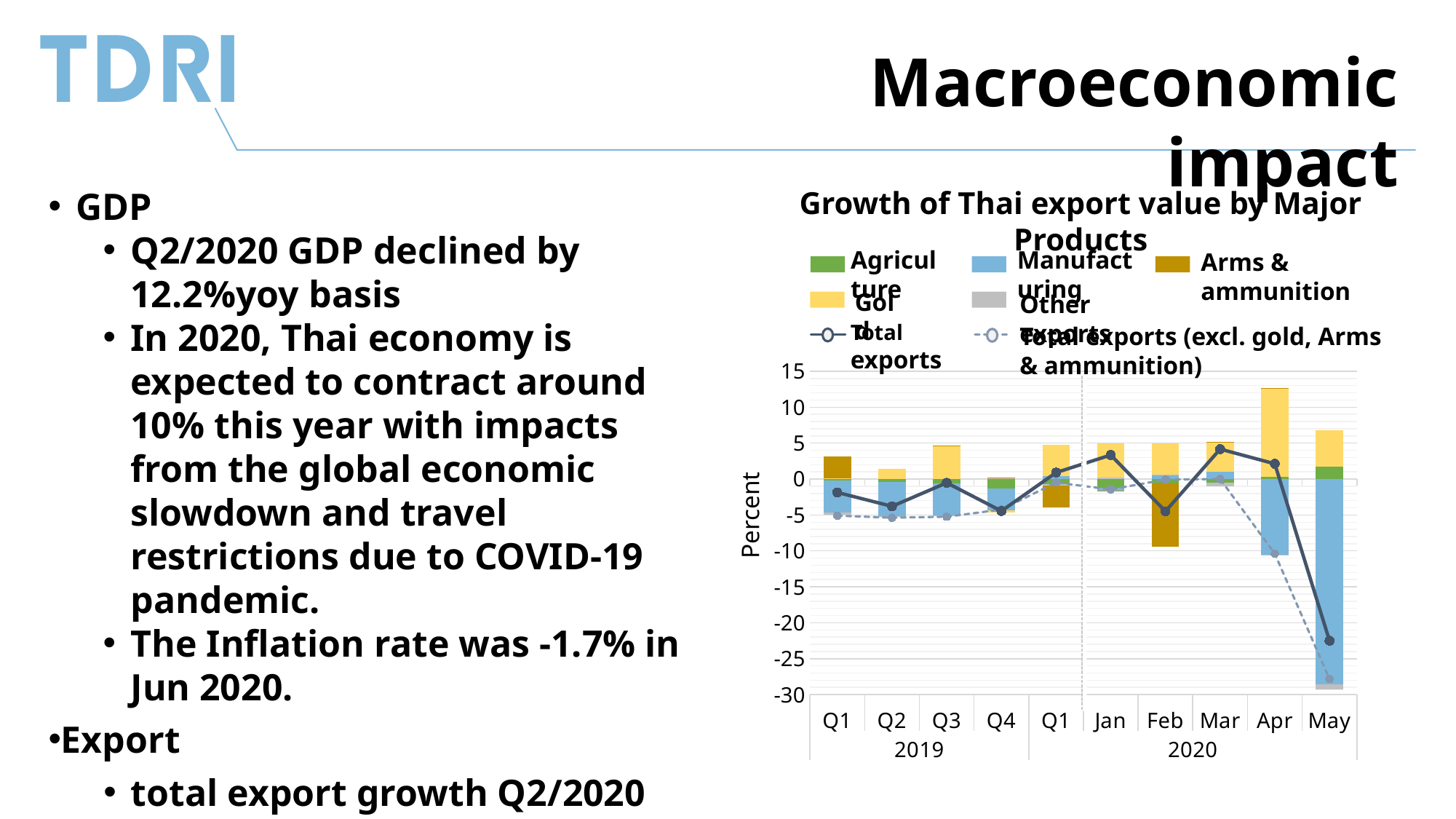
In which period does the Total exports line reach its lowest value? May 2020 What is the title of the chart on the slide? Growth of Thai export value by Major Products Does the Total exports line rise or fall from Mar 2020 to May 2020? fall How many time periods are shown along the x axis of the chart? 10 What kind of chart is shown on the slide? Stacked bar chart with line series How many series does the chart's legend list? 7 Is the Total exports value for Feb 2020 greater or less than 0? less Is the Total exports (excl. gold, Arms & ammunition) value for May 2020 greater or less than -25? less Which is larger, the Total exports value for Mar 2020 or for May 2020? Mar 2020 What is the label on the vertical axis of the chart? Percent Is the Total exports value for Apr 2020 greater or less than 0? greater